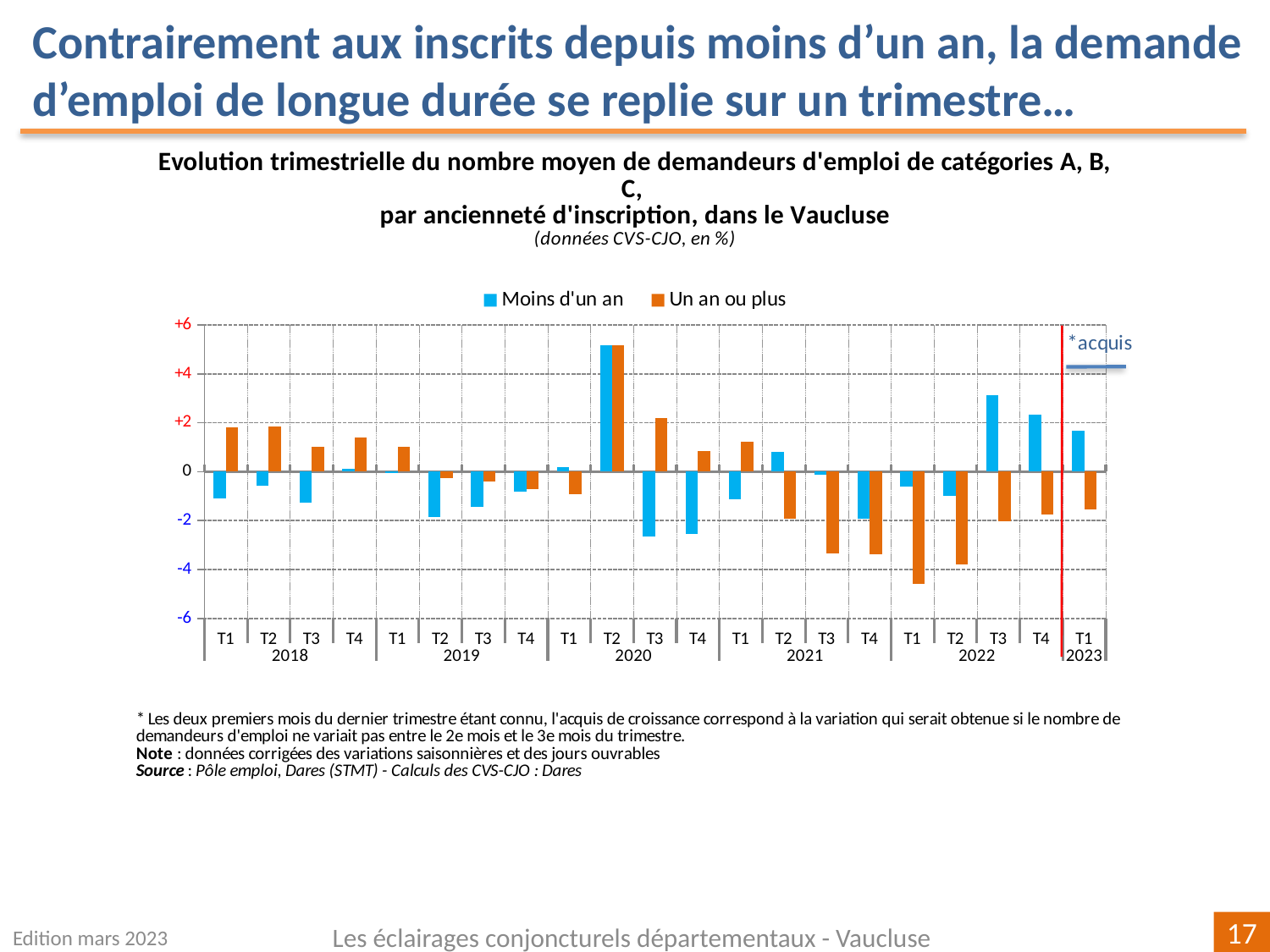
What are the two series named in the legend? Moins d'un an; Un an ou plus Is the value for 'Moins d'un an' in T2 2020 greater or less than +4? greater What kind of chart is shown on the slide? Bar chart Is the value for 'Moins d'un an' in T3 2022 greater or less than +2? greater In which quarter is the 'Moins d'un an' series at its highest? T2 2020 How many quarters are plotted along the x axis? 21 Which is larger for 'Un an ou plus': the value in T1 2018 or the value in T3 2018? T1 2018 Which is larger for 'Moins d'un an': the value in T3 2022 or the value in T4 2022? T3 2022 How many series does the legend list? 2 Is the value for 'Un an ou plus' in T3 2021 greater or less than -2? less In which quarter is the 'Un an ou plus' series at its lowest? T1 2022